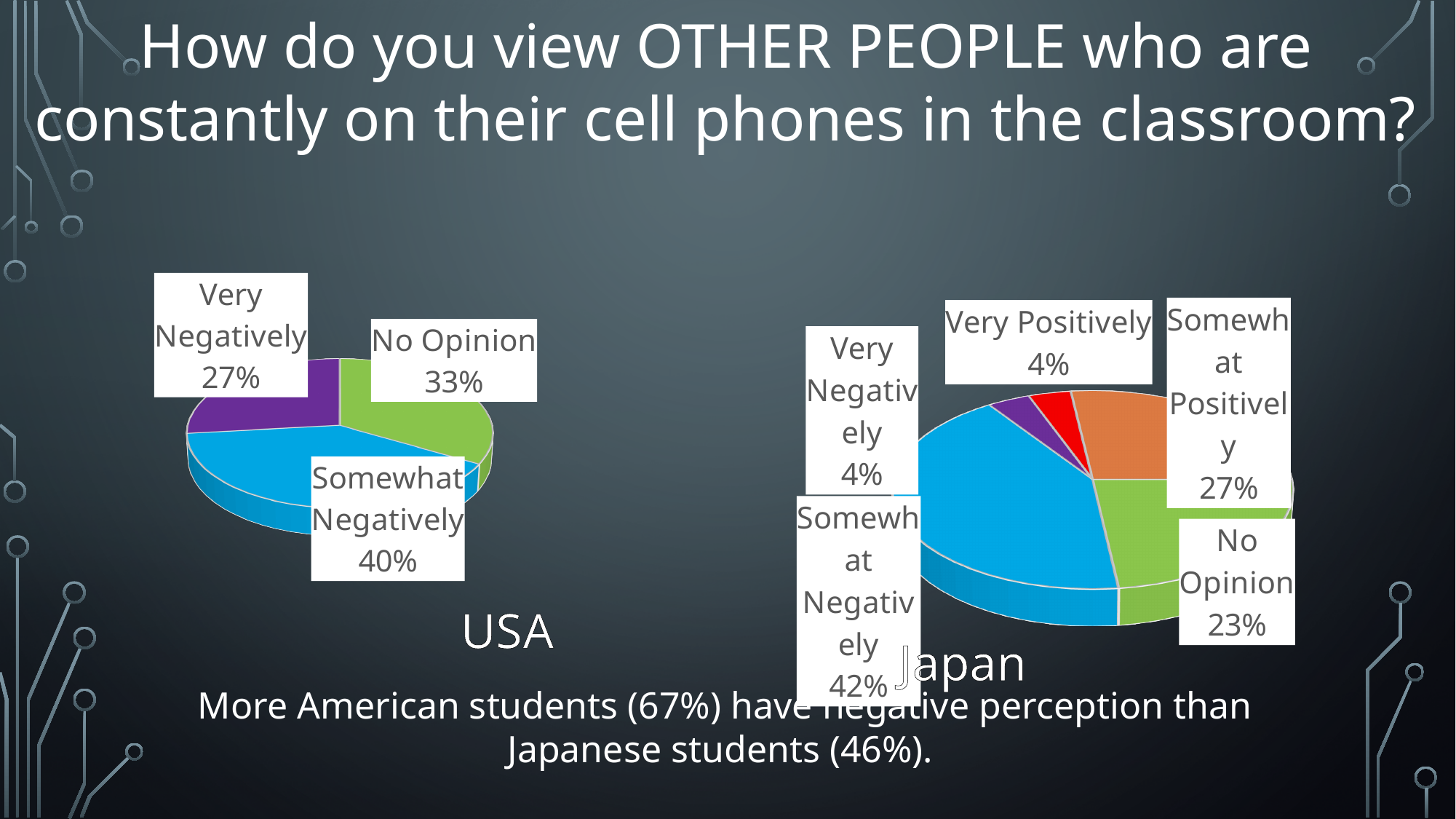
In the USA pie chart, what is the difference between the 'Somewhat Negatively' share and the 'Very Negatively' share? 13% In the Japan pie chart, which response has the largest share? Somewhat Negatively In the USA pie chart, which response has the smallest share? Very Negatively In the Japan pie chart, what is the difference between the 'Somewhat Negatively' share and the 'No Opinion' share? 19% In the Japan pie chart, what percentage of students answered 'No Opinion'? 23% In the Japan pie chart, what percentage of students answered 'Somewhat Positively'? 27% In the USA pie chart, what percentage of students answered 'No Opinion'? 33% In the USA pie chart, what percentage of students answered 'Somewhat Negatively'? 40% What type of chart is used for the USA data? Pie chart How many slices does the Japan pie chart have? 5 In the USA pie chart, which response has the largest share? Somewhat Negatively Which is larger: the 'Very Negatively' share in the USA chart or the 'Very Negatively' share in the Japan chart? USA